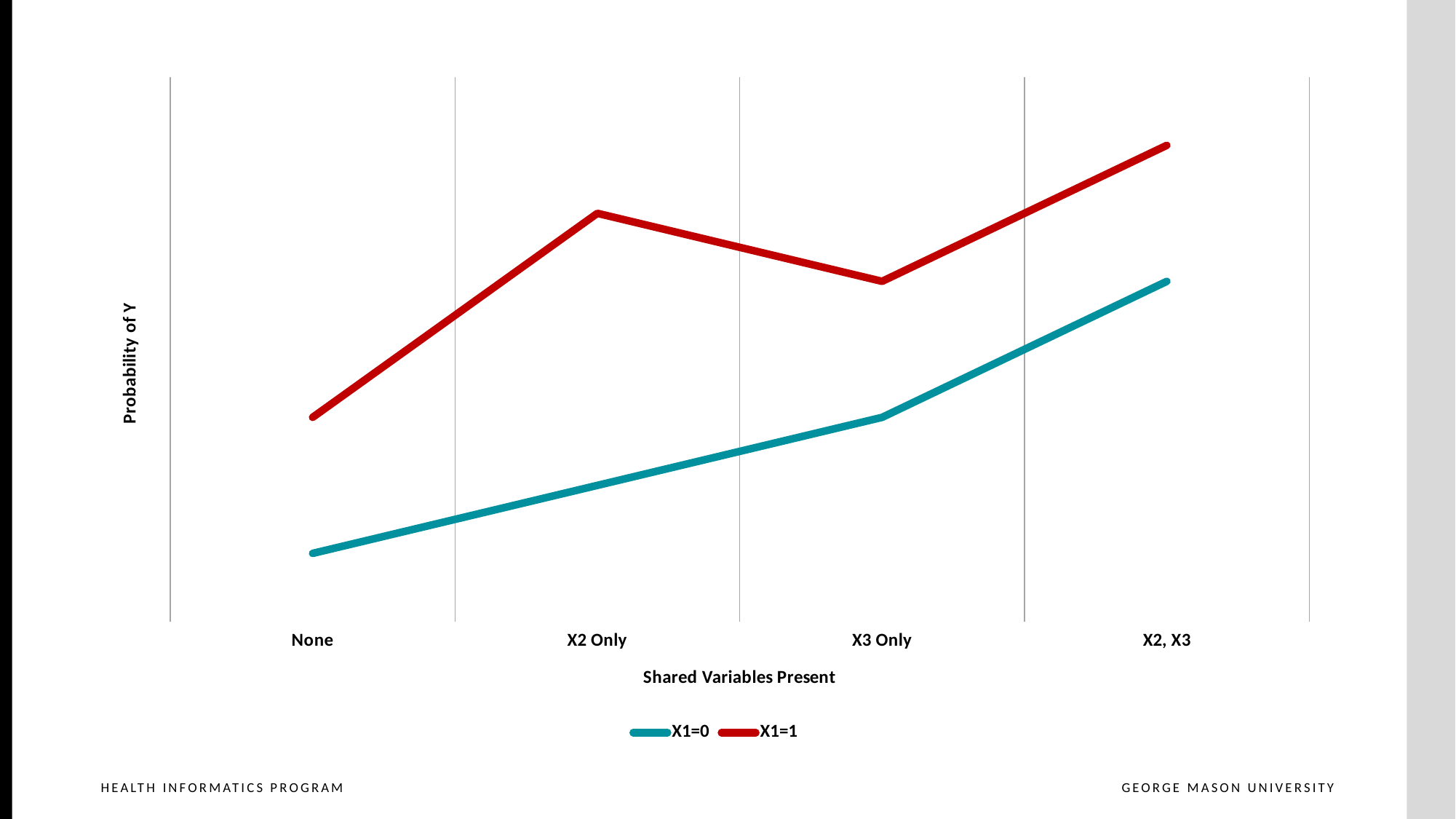
For which category is the X1=1 series highest? X2, X3 For which category is the X1=1 series lowest? None How many categories are shown on the x axis? 4 What is the label of the x axis? Shared Variables Present How many series does the legend list? 2 For which category is the X1=0 series lowest? None For which category is the X1=0 series highest? X2, X3 Does the X1=0 series rise or fall from None to X2, X3? rise Which colour is used for the X1=1 series? red For the X1=1 series, is the value at X2 Only higher or lower than at X3 Only? higher At X3 Only, which series has the higher probability of Y, X1=0 or X1=1? X1=1 What kind of chart is shown on the slide? line chart